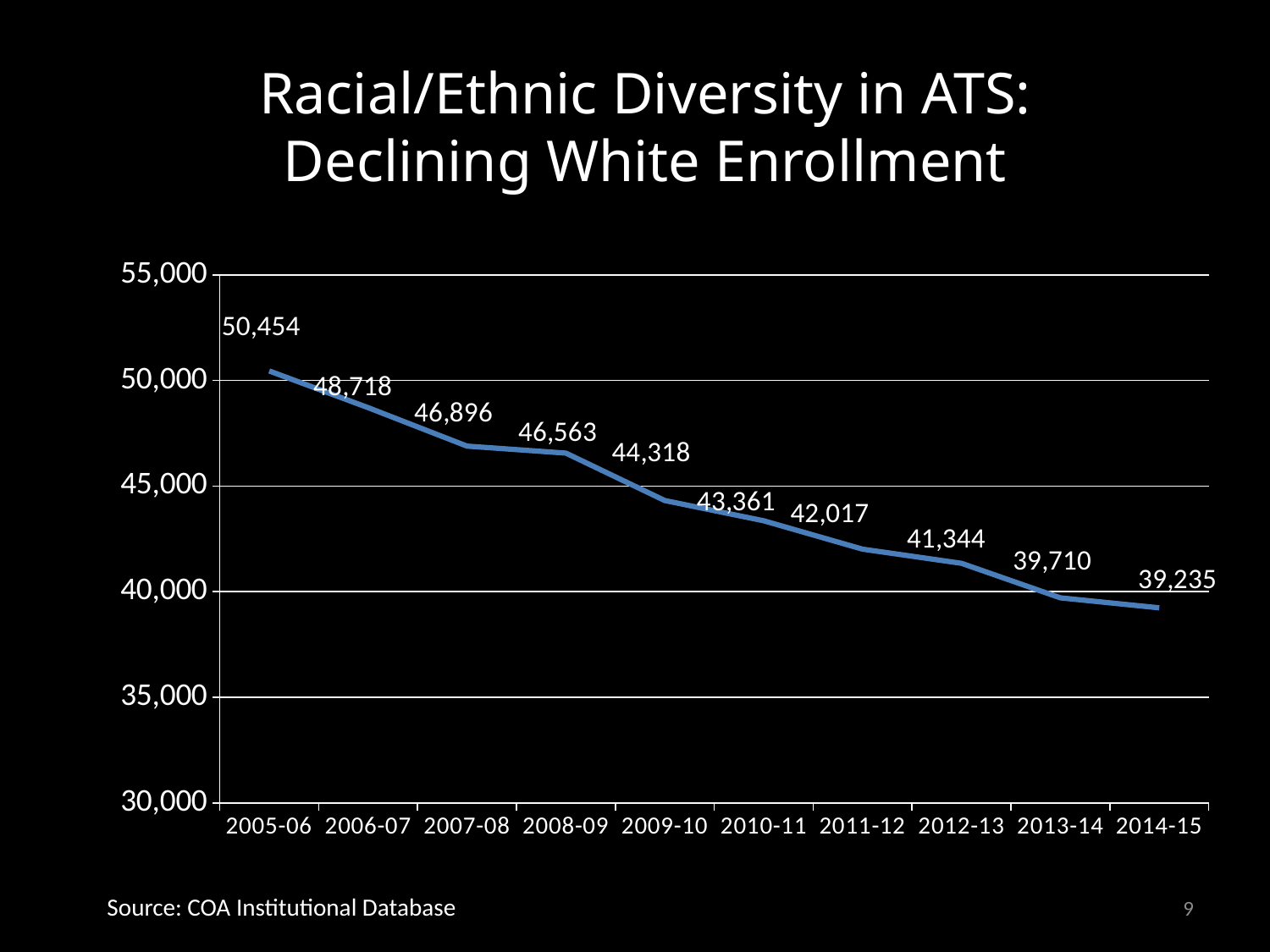
Which year has the lowest white enrollment? 2014-15 What is the white enrollment value for 2014-15? 39,235 How many academic years are plotted on the chart? 10 Do the values rise or fall from 2005-06 to 2014-15? fall What is the white enrollment value for 2009-10? 44,318 What kind of chart is shown on the slide? line chart What is the white enrollment value for 2005-06? 50,454 What is the difference in white enrollment between 2007-08 and 2008-09? 333 Which is larger, the value for 2010-11 or the value for 2012-13? 2010-11 What is the difference in white enrollment between 2005-06 and 2014-15? 11,219 Which year has the highest white enrollment? 2005-06 Is the value for 2013-14 greater or less than 40,000? less